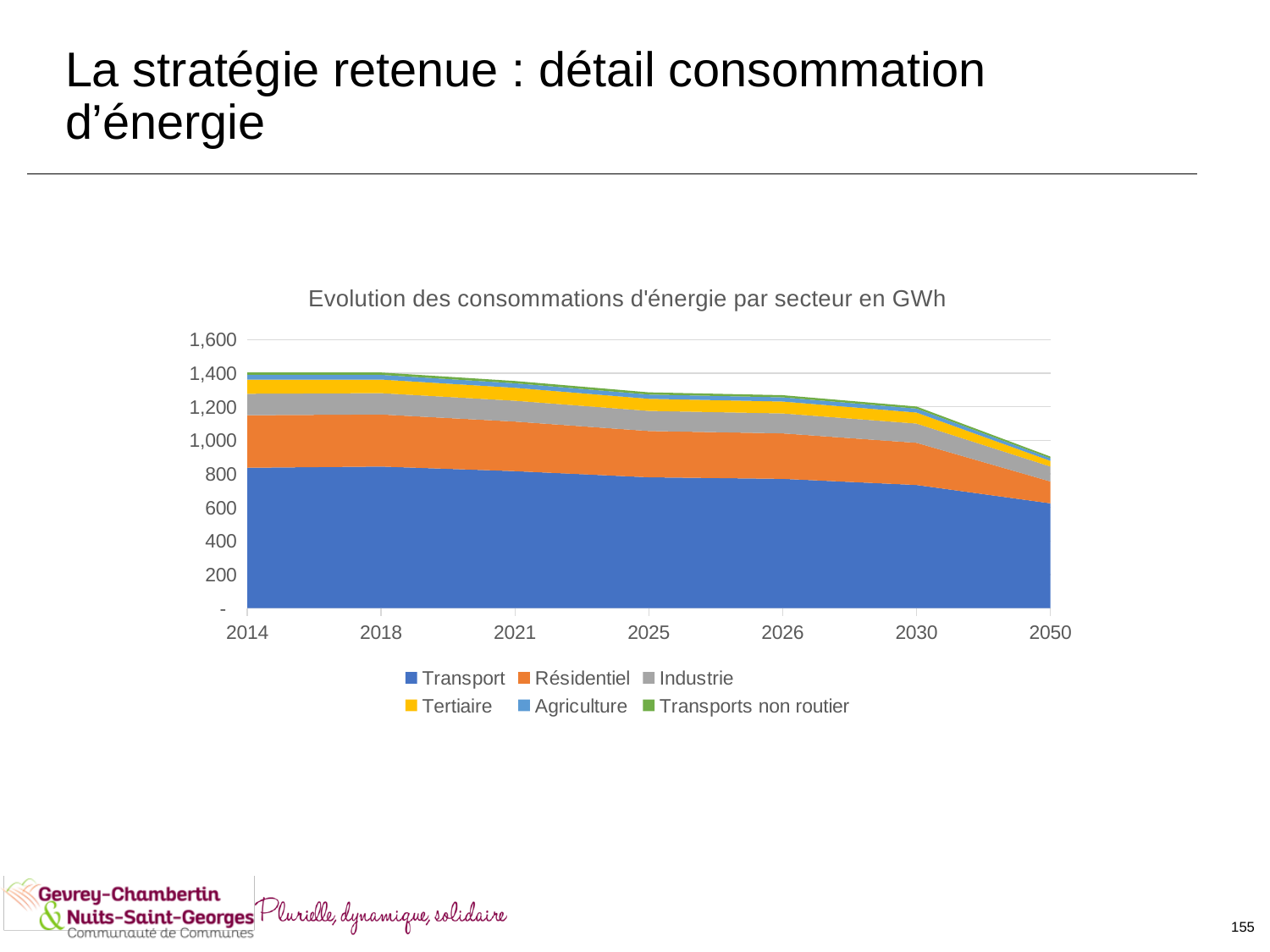
Is the value for Transport in 2014 greater or less than 800? greater How many series does the legend list? 6 In which year is the total energy consumption lowest? 2050 Which sector accounts for the largest share of energy consumption across all years? Transport How many years are shown on the x axis? 7 Is the total consumption in 2050 greater or less than 1,000? less What kind of chart is shown on the slide? Stacked area chart Does the total energy consumption rise or fall from 2014 to 2050? Fall Which series is shown in orange in the legend? Résidentiel Is the value for Transport in 2050 greater or less than 800? less In 2014, which is larger: the consumption of Transport or of Résidentiel? Transport What is the title of the chart? Evolution des consommations d'énergie par secteur en GWh